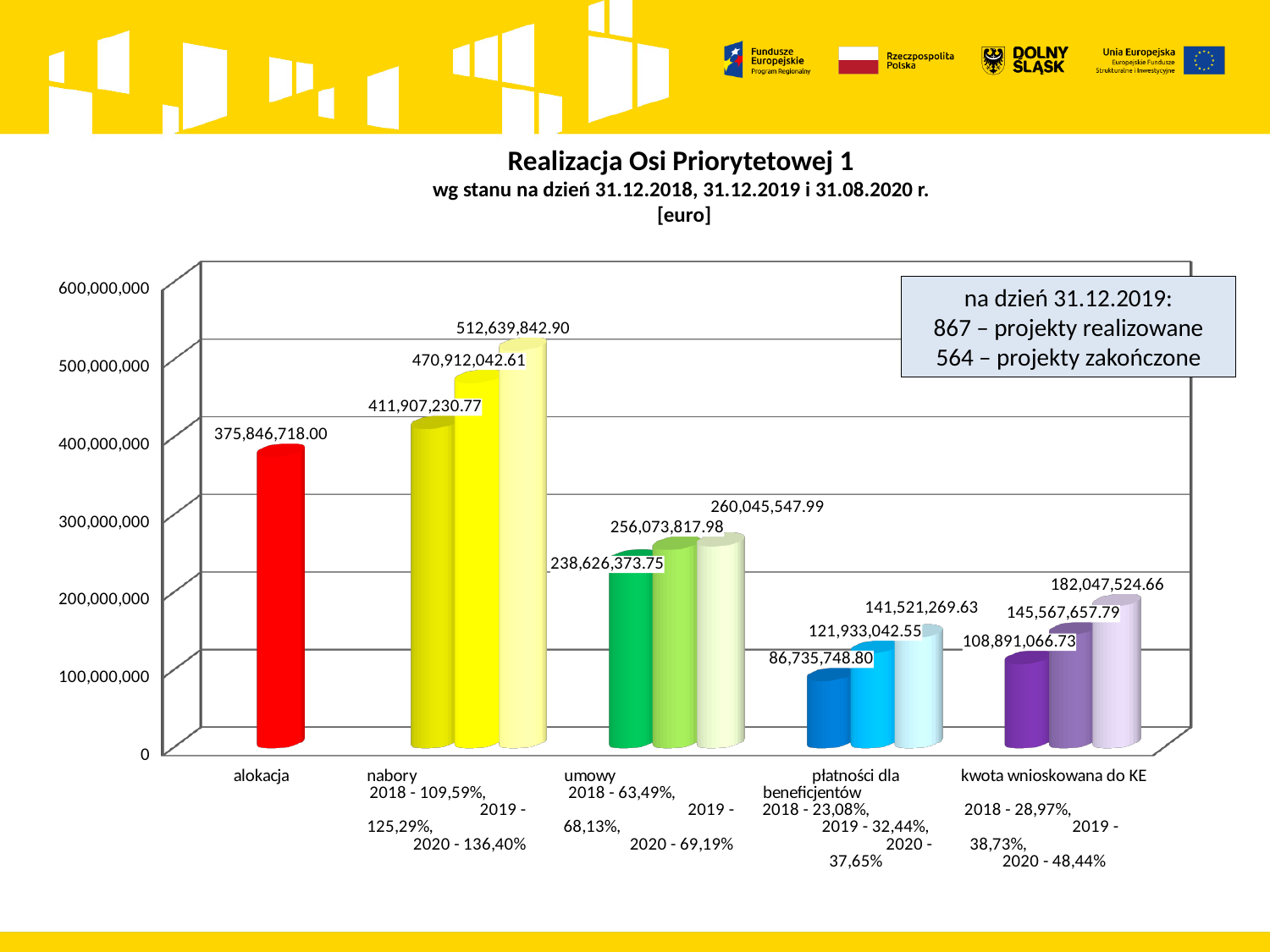
Which category group contains the highest bar on the chart? nabory What is the value of the alokacja bar? 375,846,718.00 Which is larger: the alokacja bar or the tallest bar in the umowy group? alokacja What is the value of the tallest bar in the nabory group? 512,639,842.90 What is the difference between the tallest and shortest bars in the nabory group? 100,732,612.13 What is the title of the chart? Realizacja Osi Priorytetowej 1 Which bar on the chart has the lowest value? 86,735,748.80 (płatności dla beneficjentów) What is the value of the shortest bar in the płatności dla beneficjentów group? 86,735,748.80 Is the tallest bar in the umowy group greater or less than 300,000,000? less How many category groups are shown on the x axis? 5 What is the value of the tallest bar in the kwota wnioskowana do KE group? 182,047,524.66 What type of chart is shown on the slide? bar chart